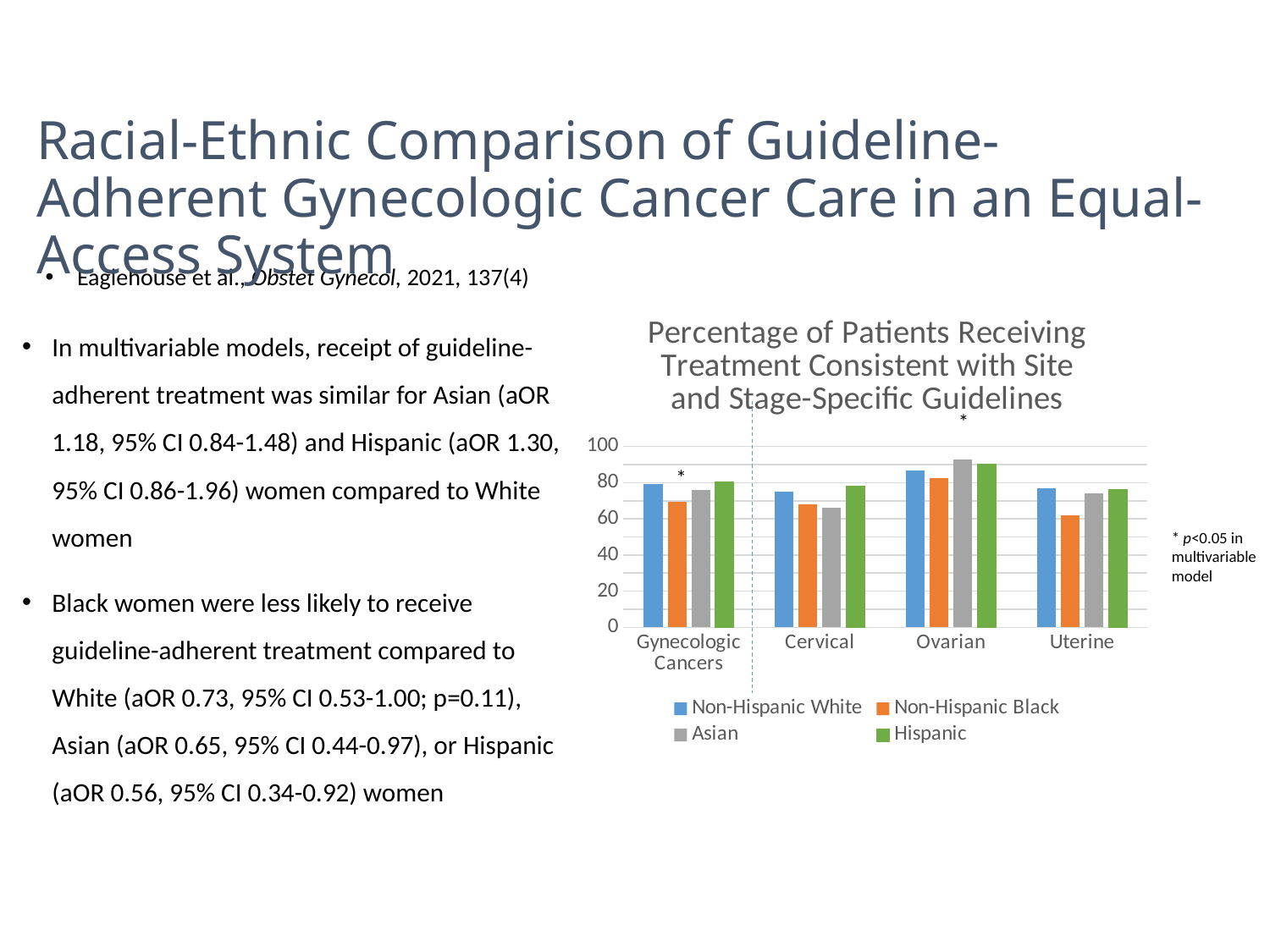
Which series is shown in green in the chart? Hispanic Which series has the lowest value in the Uterine category? Non-Hispanic Black Is the value for Asian in the Ovarian category greater or less than 80? greater Is the value for Non-Hispanic White in the Ovarian category greater or less than 80? greater How many cancer categories are shown on the x axis of the chart? 4 What is the title of the chart? Percentage of Patients Receiving Treatment Consistent with Site and Stage-Specific Guidelines Is the value for Non-Hispanic Black in the Uterine category greater or less than 80? less Which series has the lowest value in the Gynecologic Cancers category? Non-Hispanic Black Which is larger: the Non-Hispanic White value for Ovarian or the Non-Hispanic Black value for Uterine? Non-Hispanic White value for Ovarian What kind of chart is shown on the slide? bar chart How many series does the chart's legend list? 4